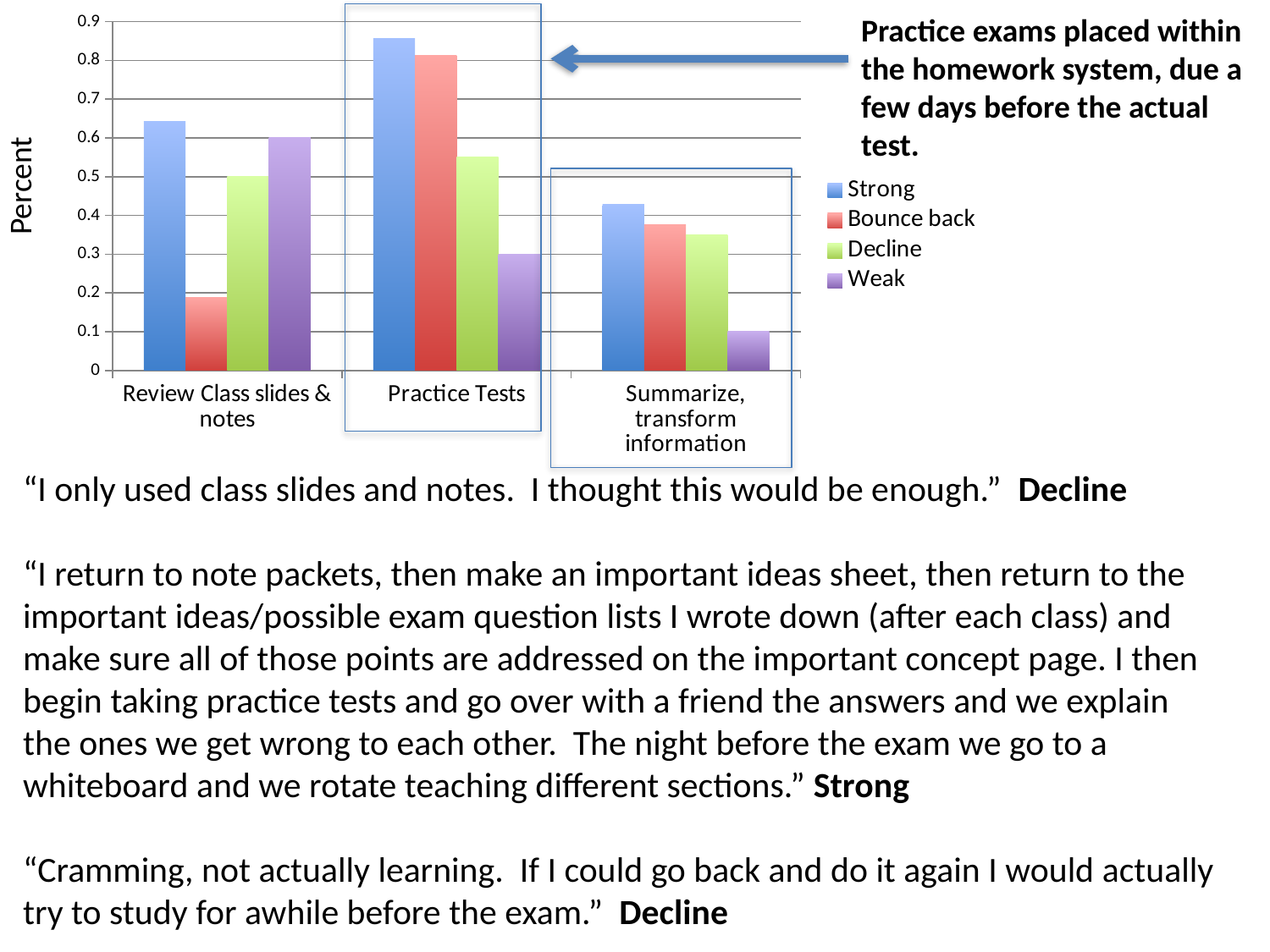
What kind of chart is shown on the slide? bar chart Which category has the lowest Weak bar? Summarize, transform information Is the Strong value for Practice Tests greater or less than 0.8? greater How many categories are shown on the x axis? 3 Is the Decline value for Practice Tests greater or less than 0.5? greater Which category has the highest Strong bar? Practice Tests How many series does the legend list? 4 For Review Class slides & notes, which is larger: the Strong value or the Bounce back value? Strong For Practice Tests, which is larger: the Decline value or the Weak value? Decline What is the label on the y axis of the chart? Percent Is the Strong value for Summarize, transform information greater or less than 0.4? greater